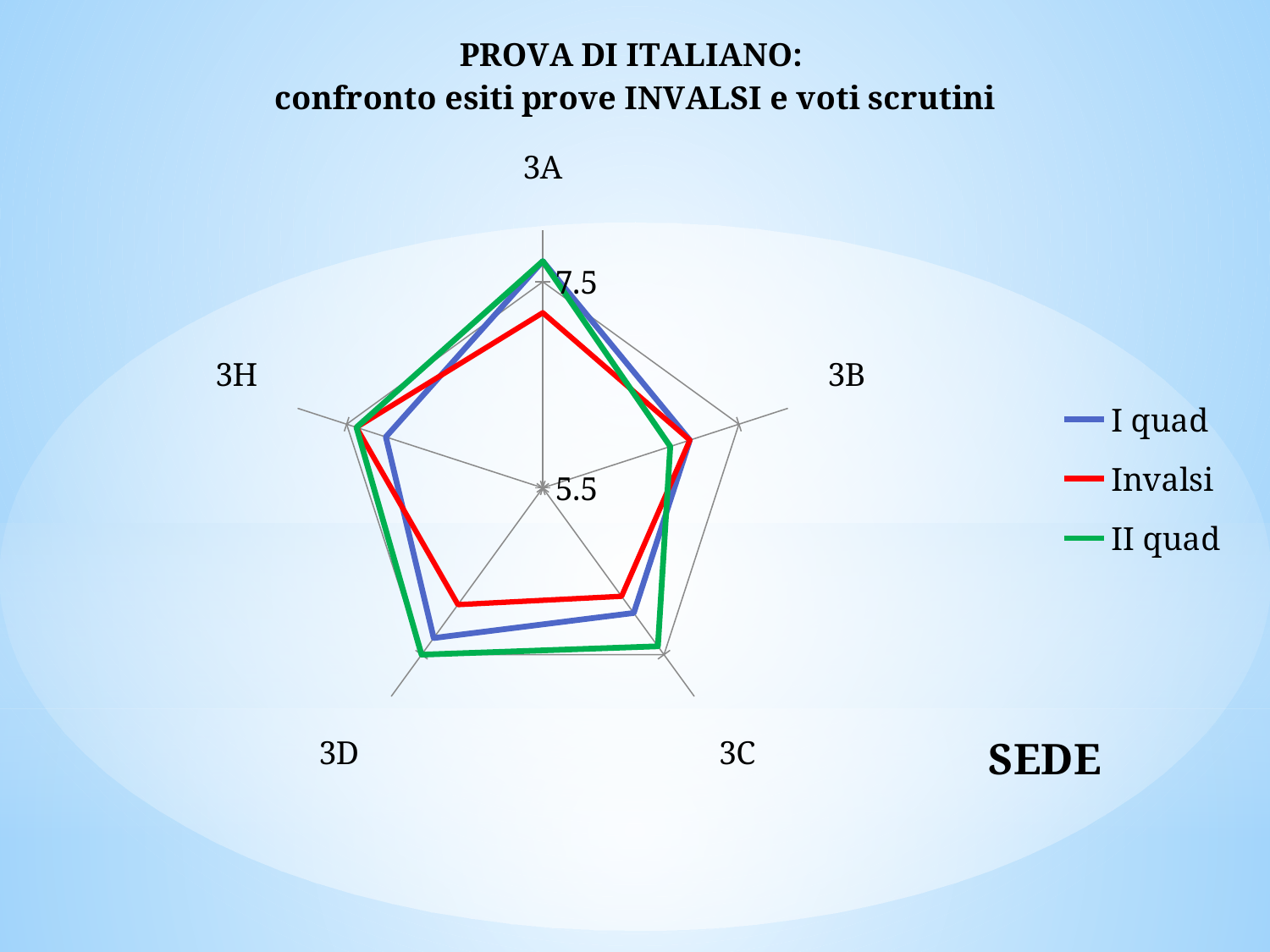
For class 3A, is the Invalsi value greater or less than 7.5? less How many classes (categories) are plotted on the radar chart? 5 What is the value shown at the centre of the radar chart? 5.5 What kind of chart is shown on the slide? Radar chart For class 3B, is the Invalsi value greater or less than 7.5? less Which series is drawn in red? Invalsi For class 3A, is the II quad value greater or less than 7.5? greater For which class is the II quad value highest? 3A How many series does the legend list? 3 For class 3H, which is larger: the Invalsi value or the I quad value? Invalsi For which class is the II quad value lowest? 3B For class 3D, which is larger: the II quad value or the Invalsi value? II quad